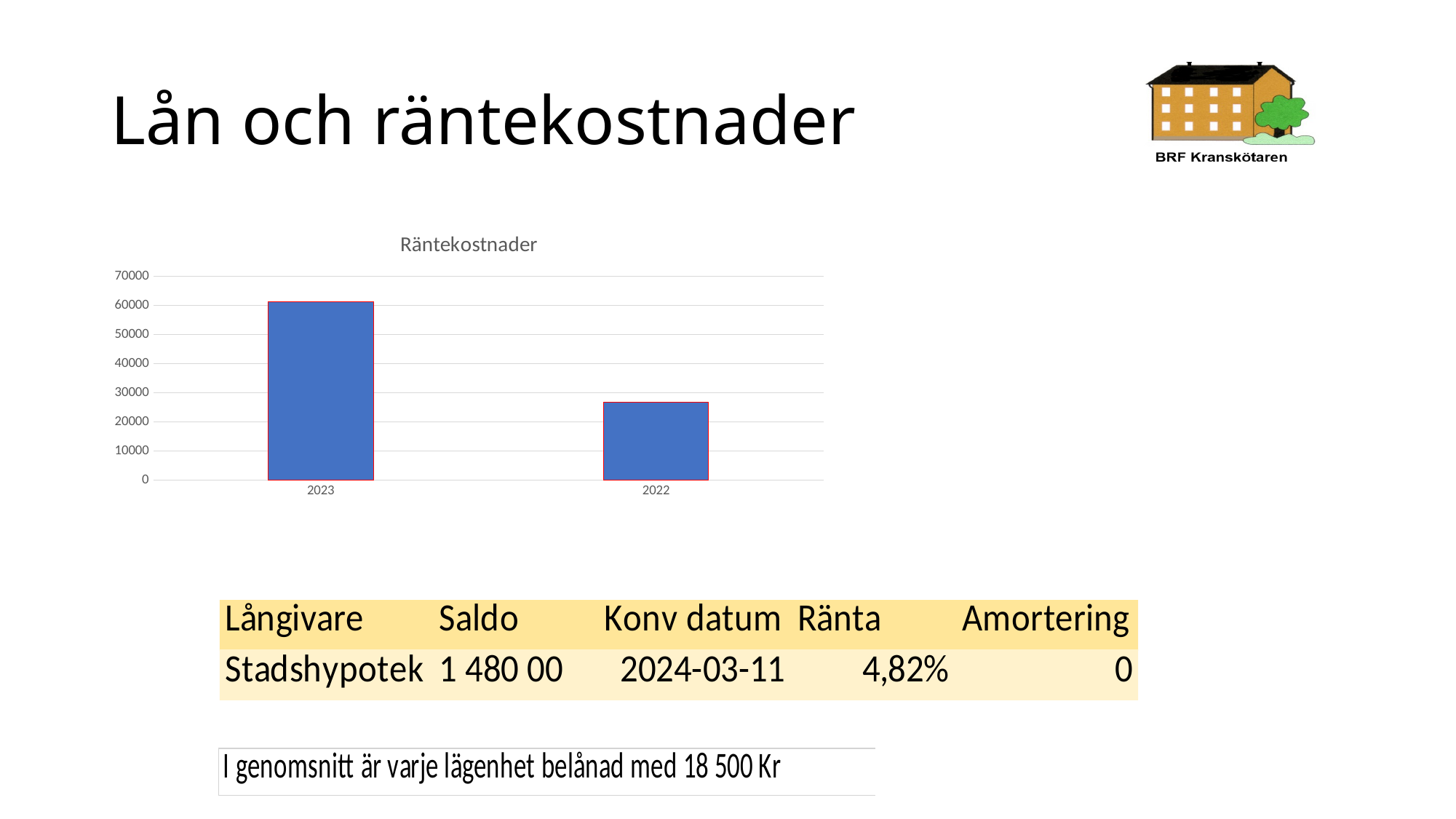
Which year has the highest value in the chart? 2023 Is the value for 2023 greater or less than 70000? less Do the bar values rise or fall from left to right along the x axis? fall What is the title of the chart? Räntekostnader Which year has the lowest value in the chart? 2022 Is the value for 2022 greater or less than 20000? greater How many bars does the chart show? 2 What kind of chart is shown on the slide? bar chart Is the value for 2022 greater or less than 30000? less What is the highest value shown on the vertical axis of the chart? 70000 Which is larger, the value for 2023 or the value for 2022? 2023